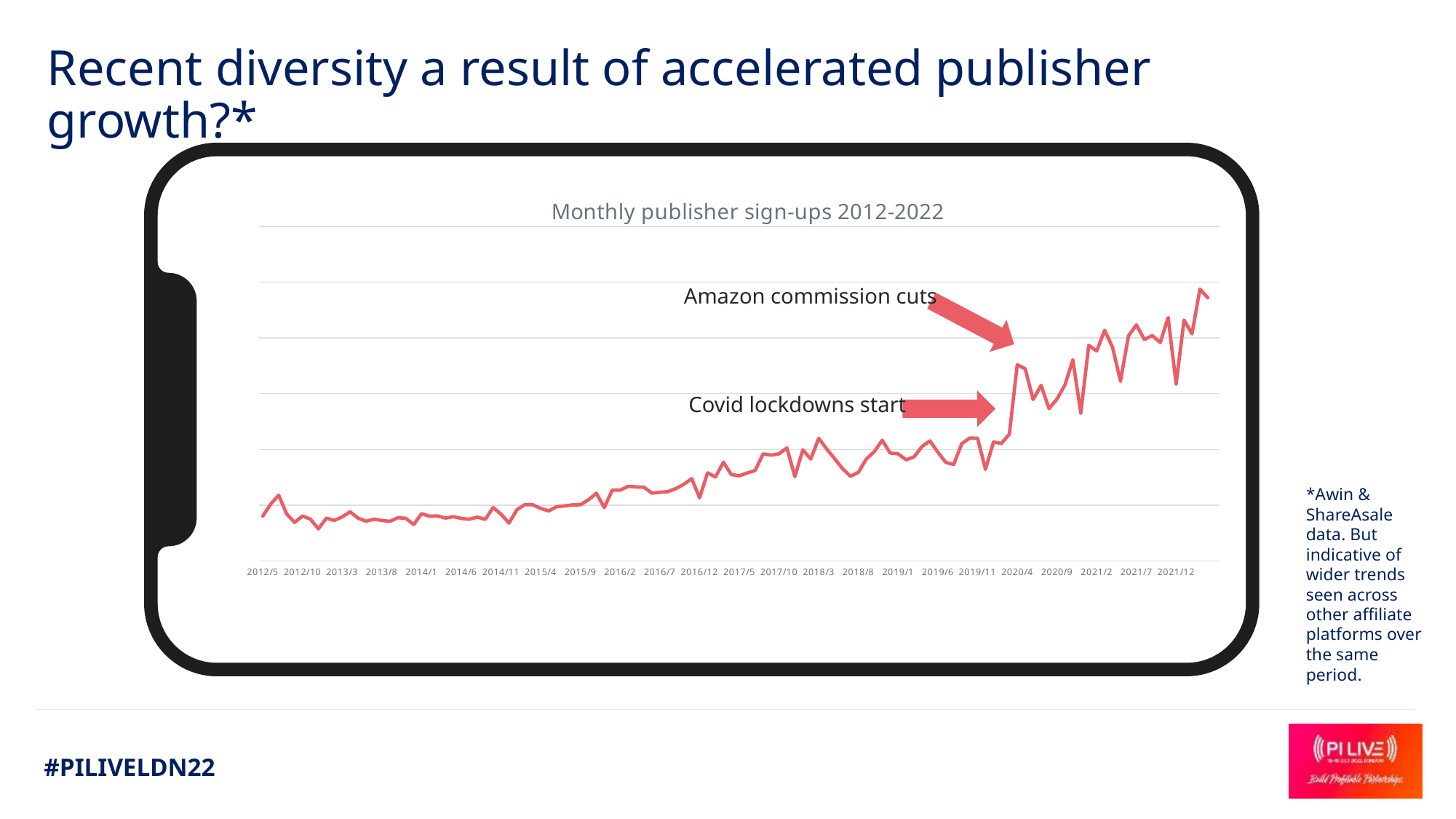
Does the line fall or rise sharply immediately after the point marked 'Covid lockdowns start'? Rise Which is larger, the value at 2012/5 or the value at 2021/12? 2021/12 What event is annotated on the chart just before the sharp jump in sign-ups around 2020? Covid lockdowns start What kind of chart is shown on the slide? Line chart Overall, do monthly publisher sign-ups rise or fall from 2012 to 2022 along the x axis? Rise Which is larger, the value at 2016/2 or the value at 2020/9? 2020/9 What is the last tick label on the x axis? 2021/12 What is the title of the chart? Monthly publisher sign-ups 2012-2022 In which part of the period does the line reach its highest point: the beginning, the middle, or the end? The end How many lines (data series) are plotted on the chart? 1 How many tick labels are shown on the x axis of the chart? 24 What is the first tick label on the x axis? 2012/5